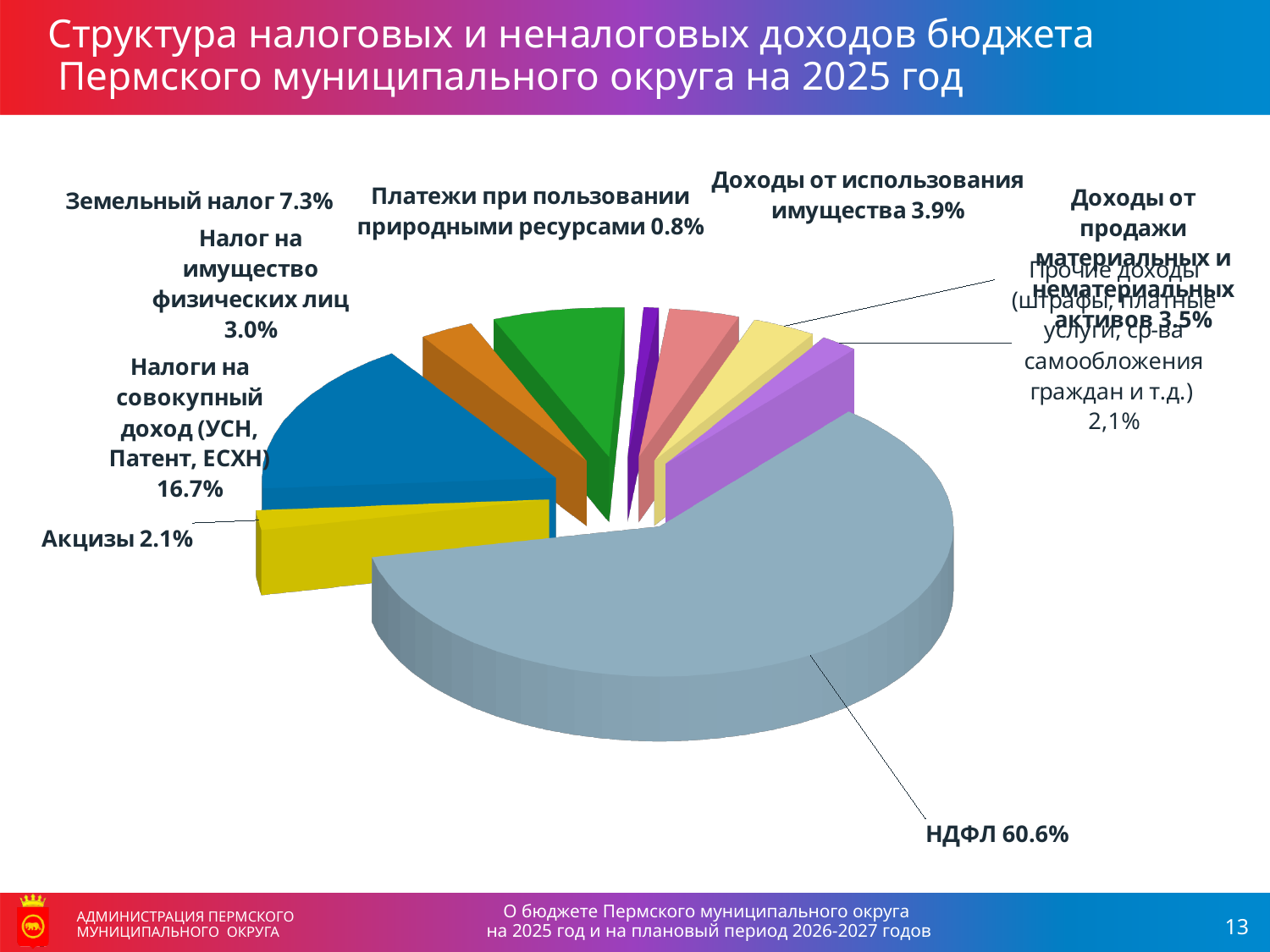
What percentage is shown for Земельный налог? 7.3% How many categories (slices) does the pie chart have? 9 By how many percentage points does НДФЛ exceed Налоги на совокупный доход (УСН, Патент, ЕСХН)? 43.9 percentage points By how many percentage points does Земельный налог exceed Налог на имущество физических лиц? 4.3 percentage points What percentage is shown for Акцизы? 2.1% What share of the budget revenue does НДФЛ account for? 60.6% Which category has the largest share of the pie? НДФЛ Which category has the smallest share of the pie? Платежи при пользовании природными ресурсами What type of chart is shown on the slide? Pie chart Which is larger: the share for Земельный налог or for Налог на имущество физических лиц? Земельный налог What share is shown for Налоги на совокупный доход (УСН, Патент, ЕСХН)? 16.7% What percentage is shown for Доходы от использования имущества? 3.9%